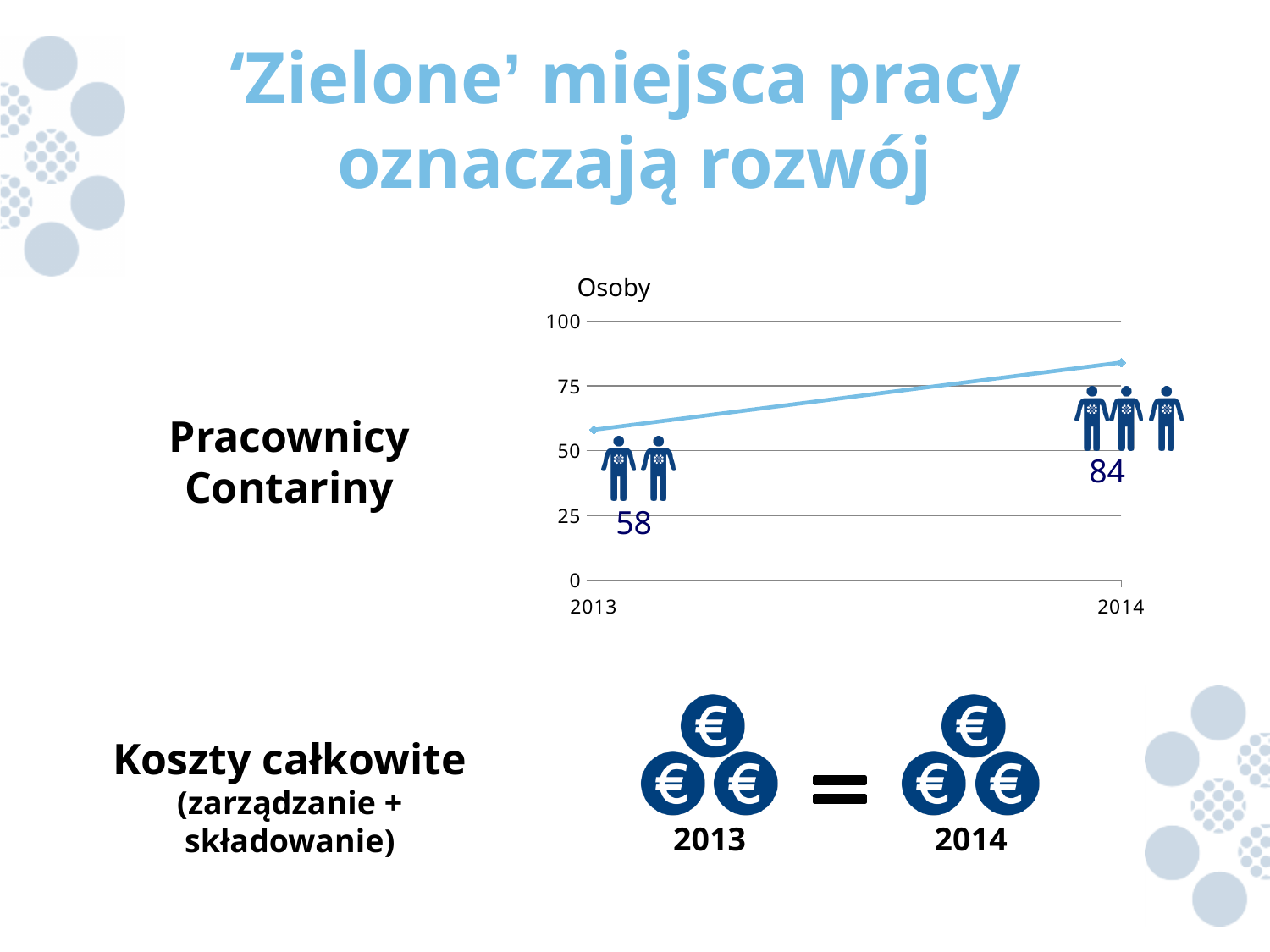
What is the label on the vertical axis of the chart? Osoby How many data points are plotted on the line chart? 2 What kind of chart is shown on the slide? line chart Is the value for 2014 greater or less than 75? greater What is the value for 2013 in the line chart? 58 Which year has the higher value in the line chart? 2014 By how much does the value in 2014 exceed the value in 2013? 26 What is the value for 2014 in the line chart? 84 Is the value for 2013 greater or less than 50? greater Does the value rise or fall from 2013 to 2014? rise Which year has the lower value in the line chart? 2013 What is the maximum value shown on the vertical axis of the chart? 100